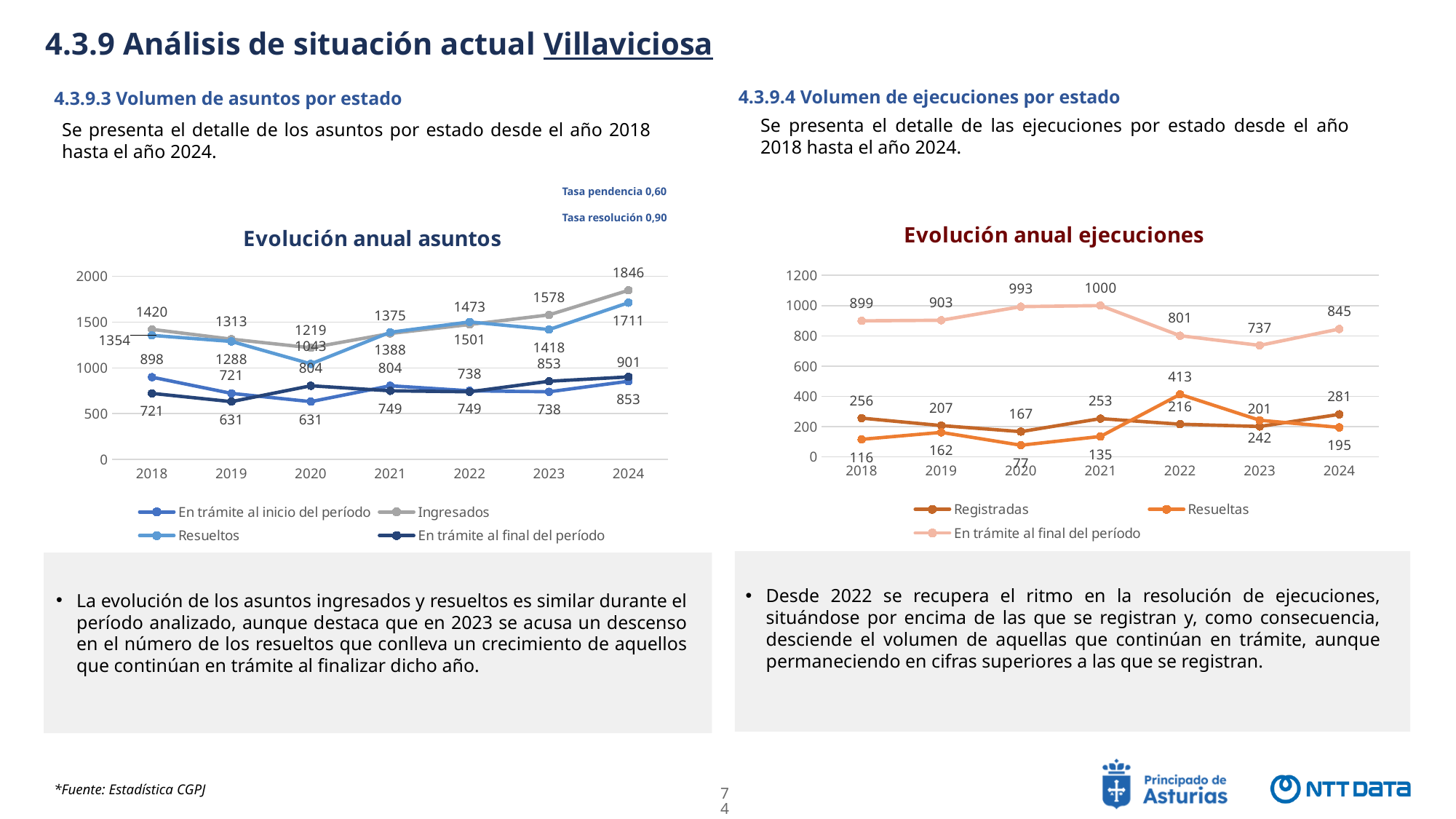
In the 'Evolución anual ejecuciones' chart, in which year is 'Resueltas' lowest? 2020 How many series does the legend of the 'Evolución anual asuntos' chart list? 4 In the 'Evolución anual ejecuciones' chart, does 'En trámite al final del período' rise or fall from 2021 to 2023? fall How many series does the legend of the 'Evolución anual ejecuciones' chart list? 3 How many years are shown on the x axis of the 'Evolución anual asuntos' chart? 7 In the 'Evolución anual ejecuciones' chart, what is the difference between 'Registradas' in 2024 and in 2018? 25 In the 'Evolución anual ejecuciones' chart, what is the value of 'En trámite al final del período' in 2021? 1000 In the 'Evolución anual asuntos' chart, is 'Ingresados' larger in 2018 or in 2024? 2024 In the 'Evolución anual asuntos' chart, what is the value of 'Ingresados' in 2024? 1846 What kind of chart is 'Evolución anual asuntos'? line chart In the 'Evolución anual ejecuciones' chart, in which year is 'En trámite al final del período' highest? 2021 In the 'Evolución anual ejecuciones' chart, what is the value of 'Resueltas' in 2022? 413